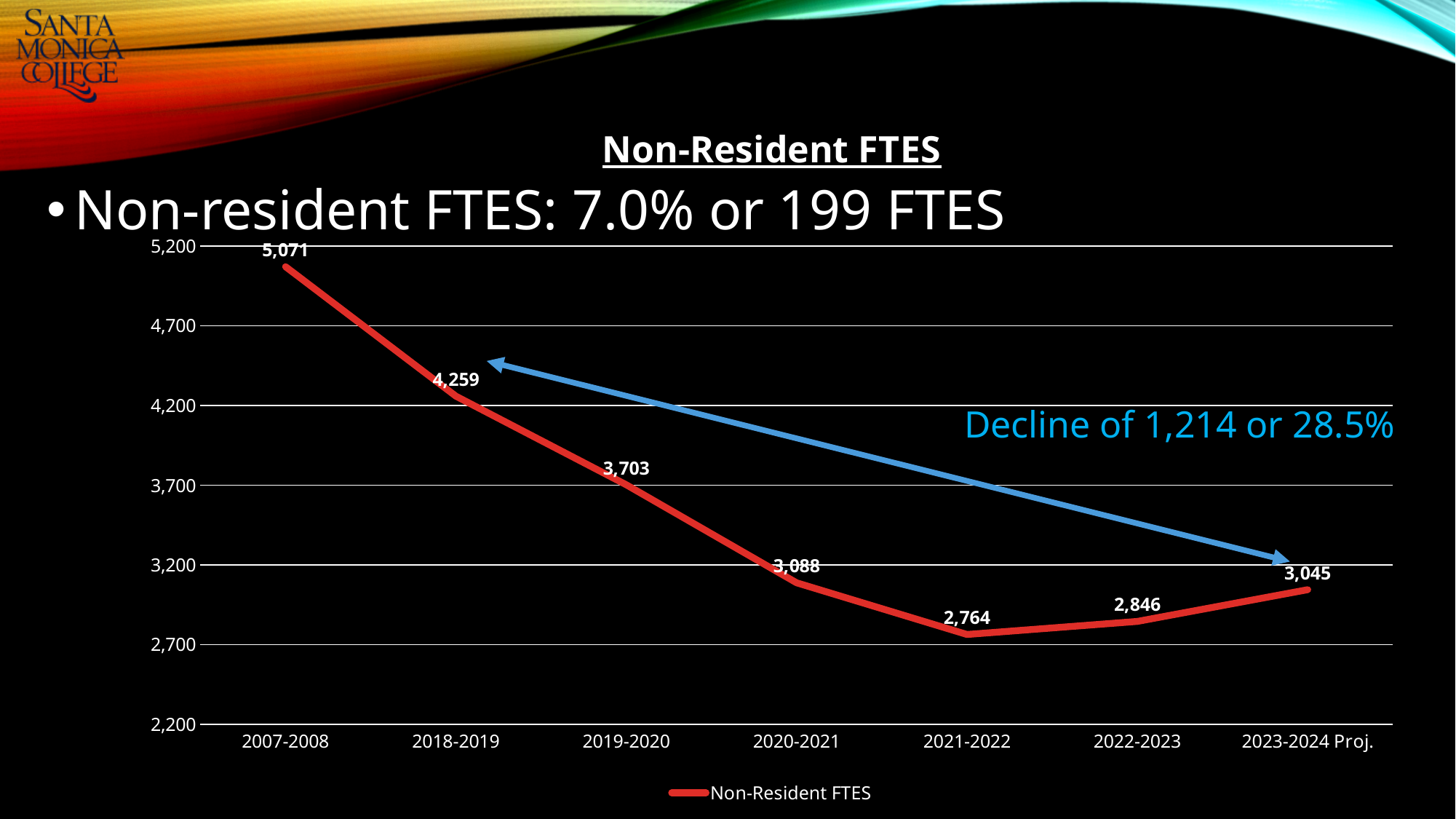
What kind of chart is shown? line chart What is the Non-Resident FTES value for 2021-2022? 2,764 How many series does the legend list? 1 What is the difference in Non-Resident FTES between 2018-2019 and 2019-2020? 556 What is the Non-Resident FTES value for 2007-2008? 5,071 Which year has the lowest Non-Resident FTES? 2021-2022 Is the Non-Resident FTES value for 2022-2023 greater or less than 3,200? less Which is larger, the Non-Resident FTES for 2020-2021 or for 2023-2024 Proj.? 2020-2021 What is the Non-Resident FTES value for 2023-2024 Proj.? 3,045 Which year has the highest Non-Resident FTES? 2007-2008 Does the Non-Resident FTES rise or fall from 2007-2008 to 2021-2022? fall How many years are plotted on the x axis? 7